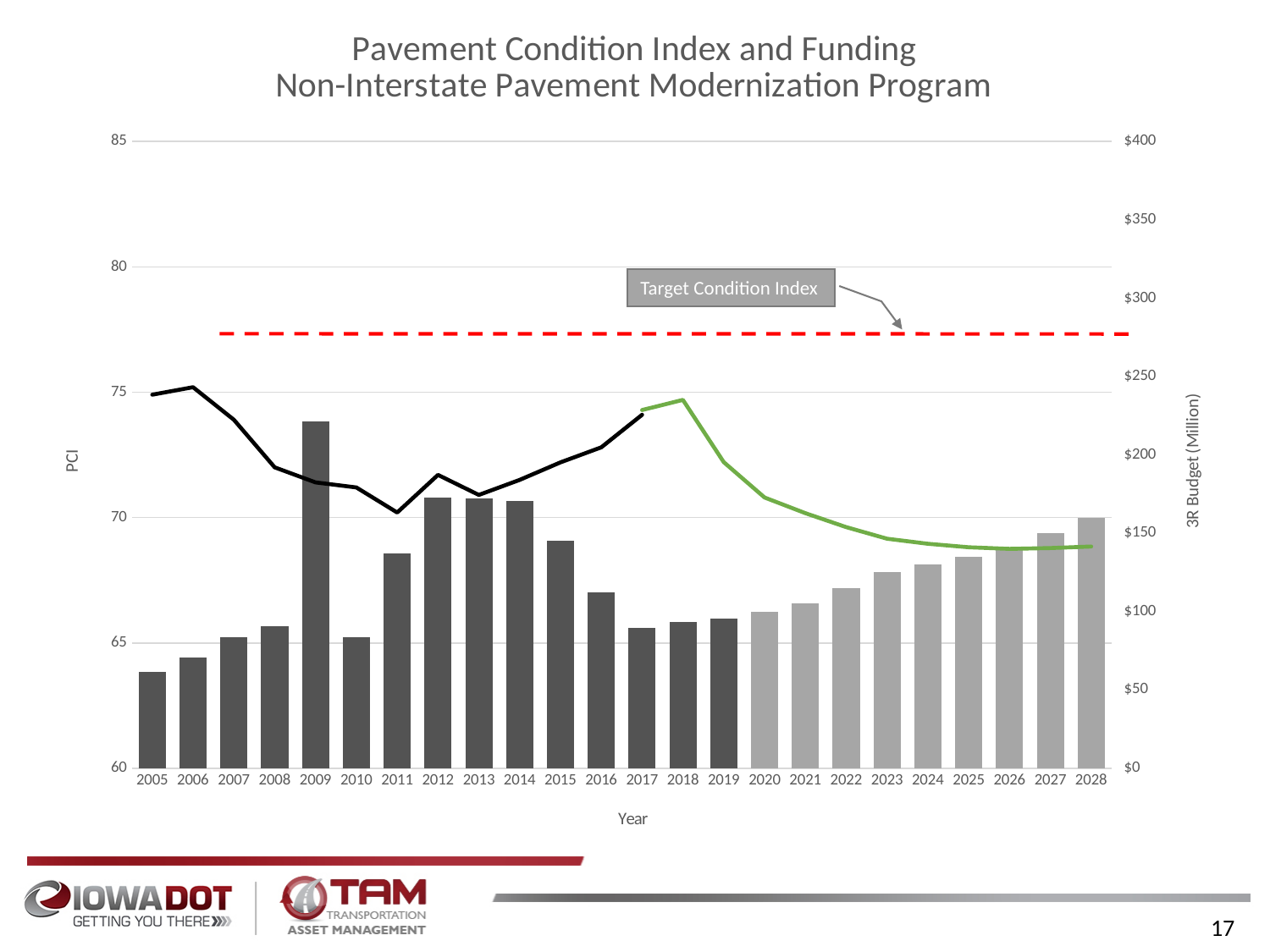
Is the 3R Budget bar for 2005 greater or less than $50 million? greater Is the 3R Budget bar for 2017 greater or less than $100 million? less Is the Target Condition Index dashed line greater or less than a PCI of 75? greater Does the green PCI line rise or fall from 2018 to 2026? fall What kind of chart is shown on the slide? A combination bar and line chart How many years are shown along the x axis of the chart? 24 What is the label of the right-hand vertical axis? 3R Budget (Million) Do the 3R Budget bars rise or fall from 2020 to 2028? rise Which year has the tallest 3R Budget bar? 2009 Which year has the larger 3R Budget bar, 2005 or 2028? 2028 Which year has the shortest 3R Budget bar? 2005